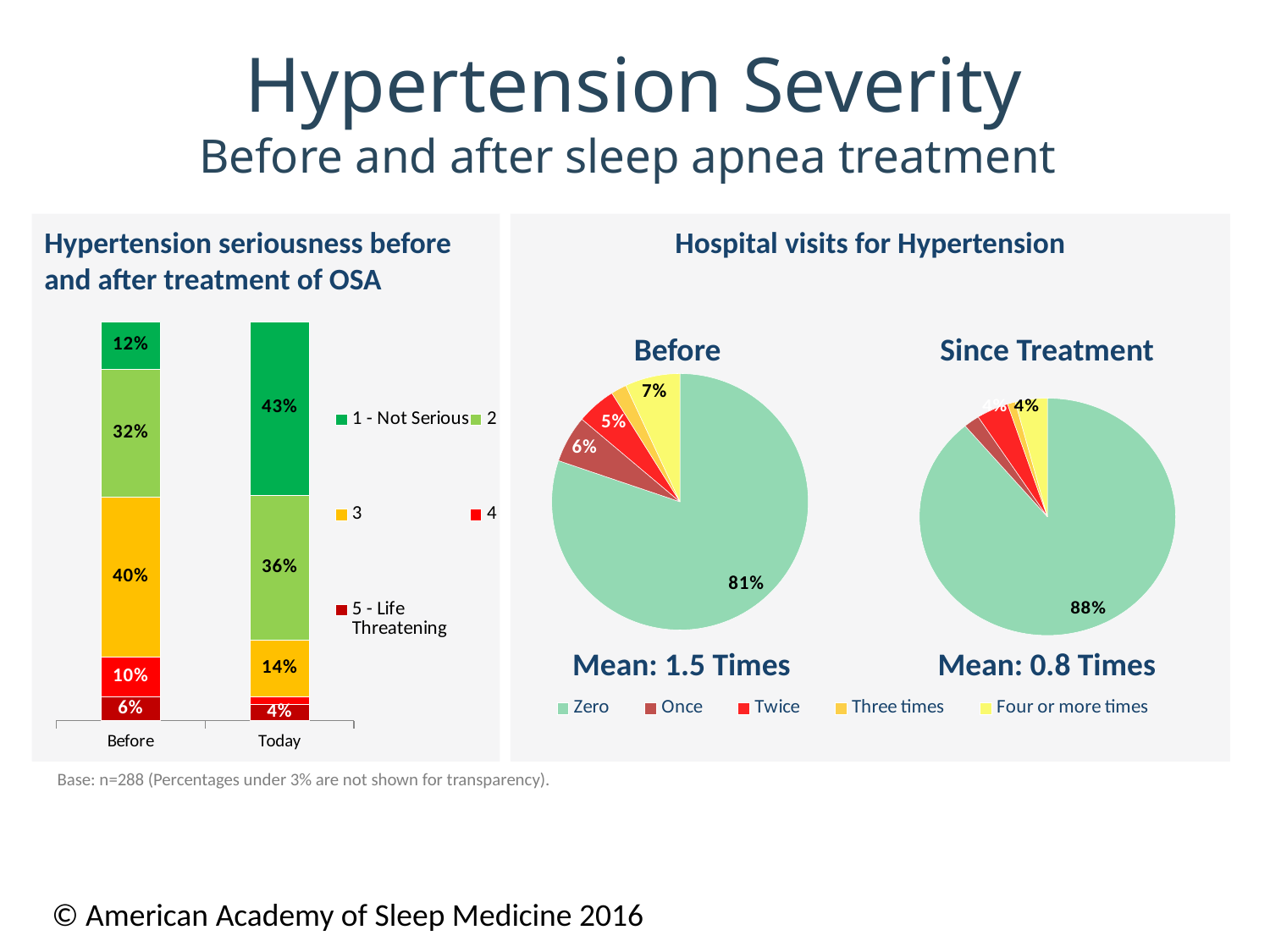
In the 'Hospital visits for Hypertension' Before pie chart, what share had Four or more times? 7% In the 'Hospital visits for Hypertension' Since Treatment pie chart, what share of respondents had Zero hospital visits? 88% What kind of chart is the 'Hypertension seriousness before and after treatment of OSA' chart? Stacked bar chart How many categories are shown on the x axis of the 'Hypertension seriousness before and after treatment of OSA' chart? 2 In the 'Hospital visits for Hypertension' charts, what is the mean number of visits shown for Before? 1.5 Times How many series does the legend of the 'Hypertension seriousness before and after treatment of OSA' chart list? 5 In the 'Hypertension seriousness before and after treatment of OSA' chart, is the share rated 3 larger for Before or for Today? Before In the 'Hospital visits for Hypertension' Before pie chart, which slice is the largest? Zero In the 'Hypertension seriousness before and after treatment of OSA' chart, what percentage of the Before bar is rated 3? 40% In the 'Hypertension seriousness before and after treatment of OSA' chart, what is the value for '5 - Life Threatening' in the Before bar? 6% In the 'Hypertension seriousness before and after treatment of OSA' chart, what percentage of the Today bar is '1 - Not Serious'? 43% In the 'Hypertension seriousness before and after treatment of OSA' chart, by how many percentage points does the '1 - Not Serious' share in Today exceed that in Before? 31 percentage points